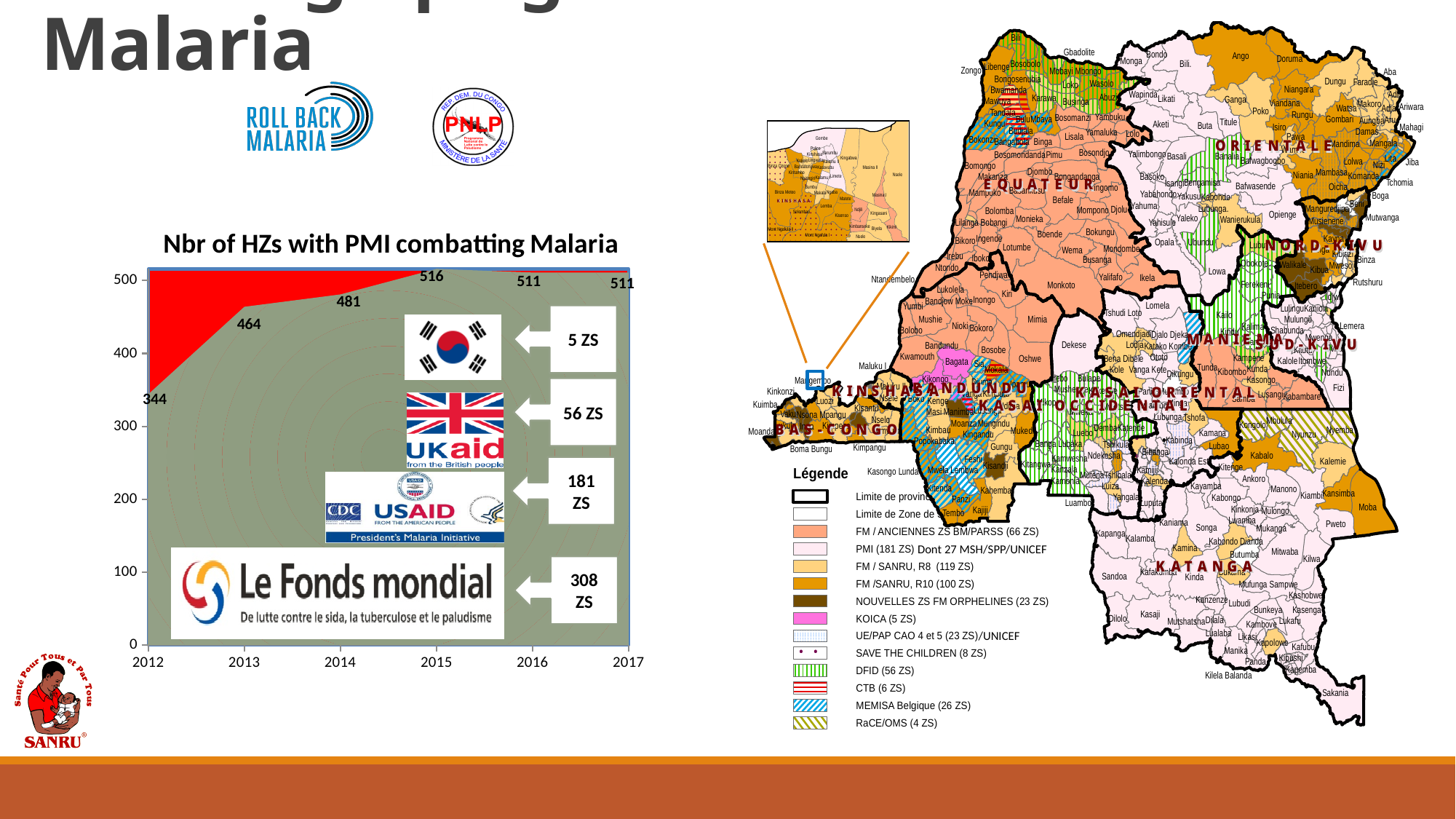
In the chart 'Nbr of HZs with PMI combatting Malaria', which year has the highest value? 2015 What kind of chart is 'Nbr of HZs with PMI combatting Malaria'? area chart In the chart 'Nbr of HZs with PMI combatting Malaria', is the value for 2014 greater or less than 500? less In the chart 'Nbr of HZs with PMI combatting Malaria', which year has the lowest value? 2012 In the chart 'Nbr of HZs with PMI combatting Malaria', what is the value for 2015? 516 How many years are shown on the x axis of the chart 'Nbr of HZs with PMI combatting Malaria'? 6 In the chart 'Nbr of HZs with PMI combatting Malaria', what is the value for 2012? 344 In the chart 'Nbr of HZs with PMI combatting Malaria', do the values rise or fall from 2012 to 2015? rise In the chart 'Nbr of HZs with PMI combatting Malaria', what is the value for 2017? 511 In the chart 'Nbr of HZs with PMI combatting Malaria', which year has the larger value, 2013 or 2014? 2014 In the chart 'Nbr of HZs with PMI combatting Malaria', what is the difference between the values for 2015 and 2014? 35 In the chart 'Nbr of HZs with PMI combatting Malaria', what is the difference between the values for 2013 and 2012? 120